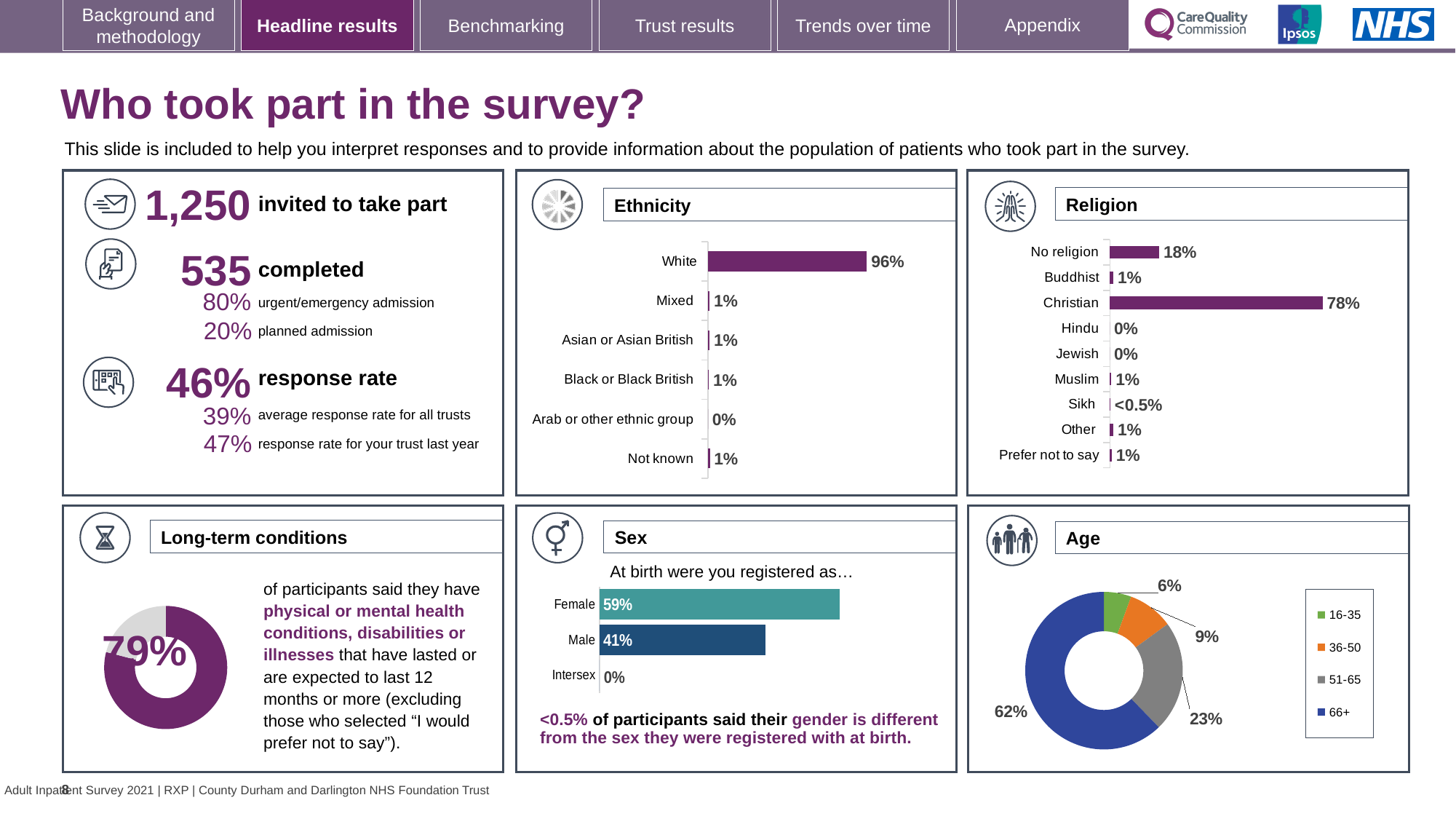
In the Sex chart, which is larger, Female or Male? Female How many categories are shown in the Ethnicity chart? 6 How many categories are shown in the Religion chart? 9 What kind of chart is used in the Age panel? Donut chart How many age groups does the legend of the Age chart list? 4 In the Age chart, what share of participants were aged 66+? 62% In the Religion chart, what value is shown for Sikh? <0.5% In the Religion chart, what percentage of participants were Christian? 78% In the Sex chart, what percentage of participants were registered as Female at birth? 59% In the Ethnicity chart, what percentage of participants were White? 96% In the Ethnicity chart, which category has the highest value? White In the Religion chart, what is the difference between the Christian and No religion values? 60%